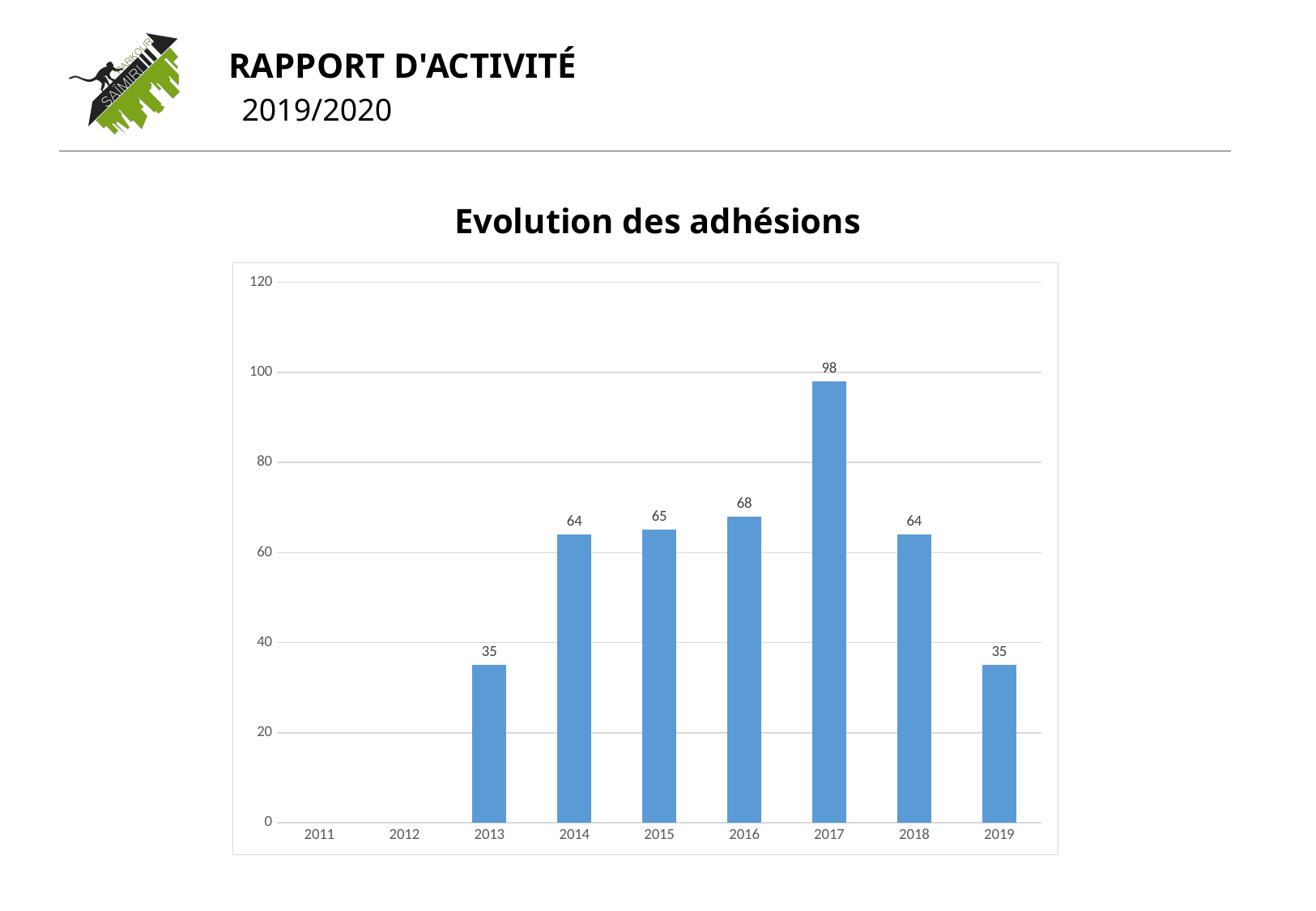
Which is larger, the value for 2015 or the value for 2014? 2015 Which year has the highest value? 2017 What is the value for 2016? 68 Is the value for 2017 greater or less than 80? greater What is the value for 2013? 35 How many years are shown on the x axis? 9 What is the value for 2017 in the Evolution des adhésions chart? 98 What is the title of the chart? Evolution des adhésions What is the difference between the values for 2016 and 2019? 33 What kind of chart is shown on the slide? bar chart Do the values rise or fall from 2013 to 2017? rise What is the difference between the values for 2017 and 2018? 34